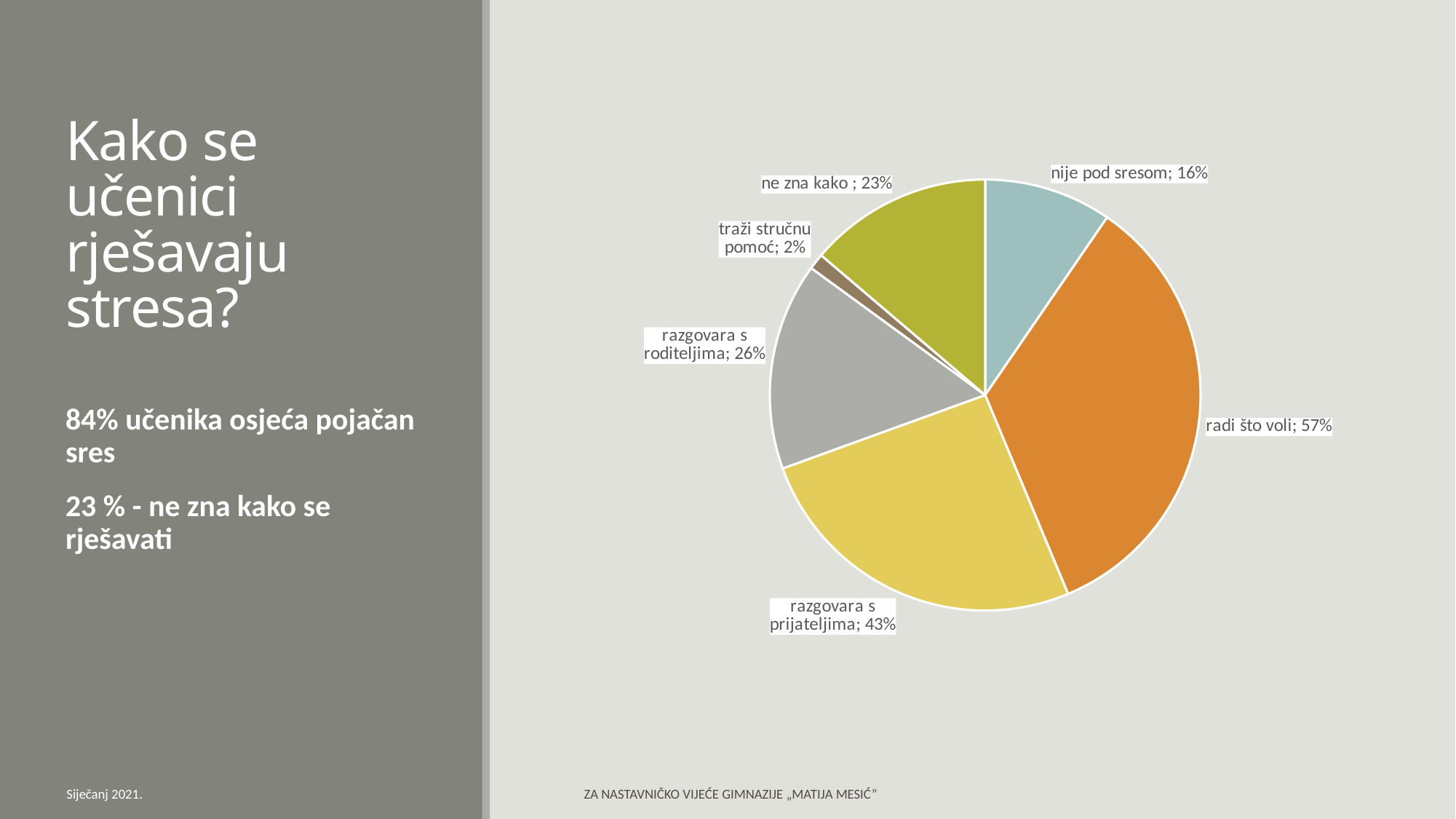
What percentage is shown for "radi što voli"? 57% How many slices does the pie chart have? 6 What percentage is shown for "nije pod sresom"? 16% Which category has the smallest slice in the pie chart? traži stručnu pomoć What colour is the "radi što voli" slice? orange What percentage is shown for "razgovara s roditeljima"? 26% Which category has the largest slice in the pie chart? radi što voli What is the difference in percentage points between "radi što voli" and "razgovara s prijateljima"? 14 What percentage is shown for "razgovara s prijateljima"? 43% What kind of chart is shown on the slide? pie chart What percentage is shown for "traži stručnu pomoć"? 2% Which is larger, "ne zna kako" or "razgovara s roditeljima"? razgovara s roditeljima